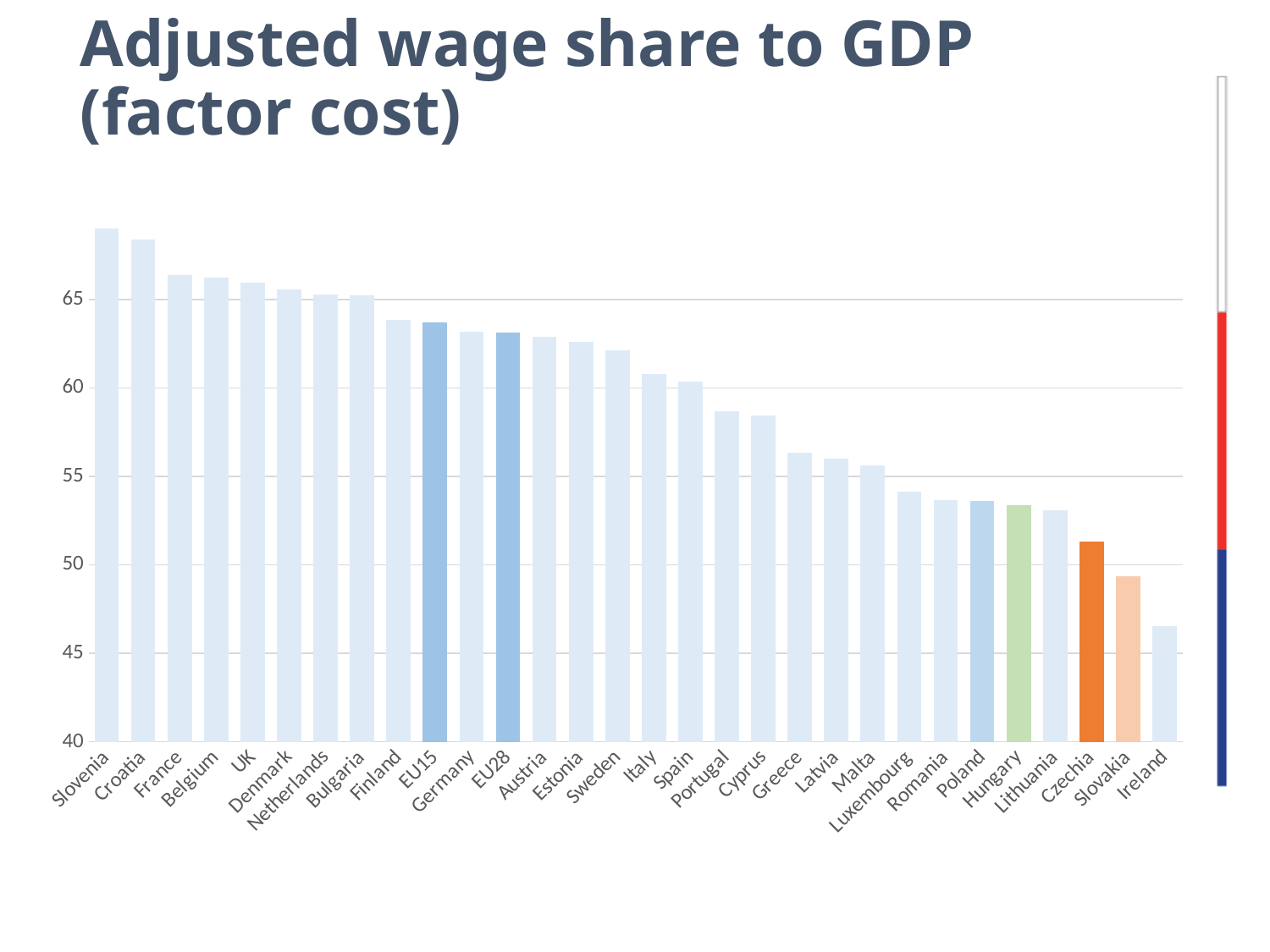
Do the values rise or fall moving from left to right along the x axis? fall What is the title of the chart on the slide? Adjusted wage share to GDP (factor cost) Is the value for Portugal greater or less than 60? less What kind of chart is shown on the slide? bar chart Is the value for Finland greater or less than 65? less Is the value for Ireland greater or less than 50? less Which country has the lowest adjusted wage share to GDP in the chart? Ireland Which has the larger adjusted wage share, Czechia or Slovakia? Czechia Which country has the highest adjusted wage share to GDP in the chart? Slovenia How many countries or groups are shown on the x axis of the chart? 30